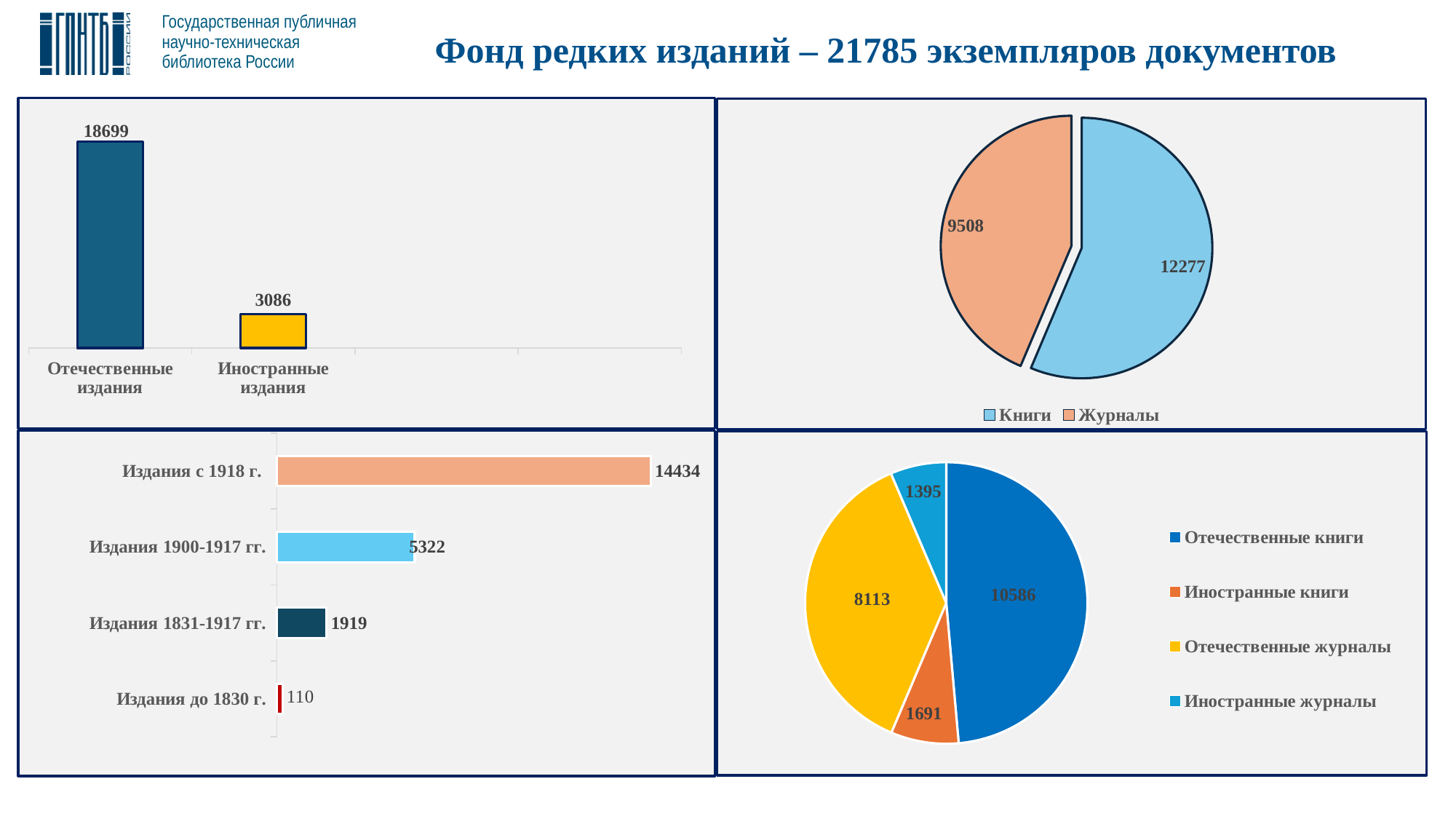
In the bottom-right pie chart, how many entries does the legend list? 4 In the top-right pie chart, which slice is larger, Книги or Журналы? Книги In the bottom-left bar chart, what is the difference between Издания с 1918 г. and Издания 1900-1917 гг.? 9112 In the bottom-left bar chart, how many categories are shown? 4 In the bottom-left bar chart, which category has the lowest value? Издания до 1830 г. In the top-left bar chart, what is the difference between Отечественные издания and Иностранные издания? 15613 In the top-right pie chart, what is the value for Журналы? 9508 In the top-left bar chart, what is the value for Отечественные издания? 18699 What kind of chart is shown in the top-left panel of the slide? Bar chart In the bottom-left bar chart, what is the value for Издания 1900-1917 гг.? 5322 In the bottom-right pie chart, what is the value for Отечественные журналы? 8113